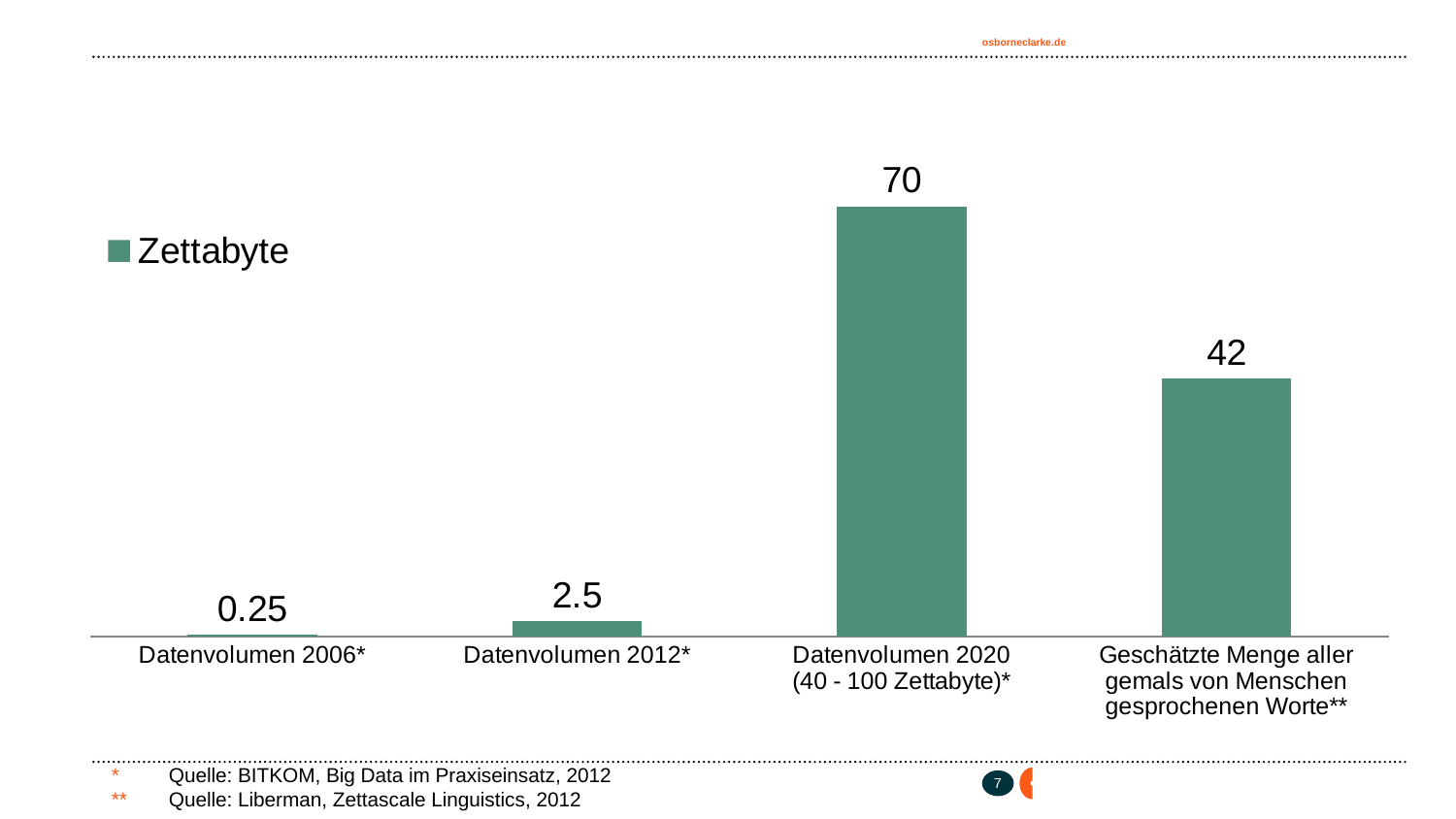
What kind of chart is shown on the slide? bar chart Which category has the lowest value? Datenvolumen 2006* Which category has the highest value? Datenvolumen 2020 (40 - 100 Zettabyte)* How many categories are shown on the x axis? 4 What is the value for Datenvolumen 2006*? 0.25 What is the value for Geschätzte Menge aller gemals von Menschen gesprochenen Worte**? 42 How many series does the legend list? 1 What is the value for Datenvolumen 2012*? 2.5 What is the difference between the values for Datenvolumen 2012* and Datenvolumen 2006*? 2.25 What is the value for Datenvolumen 2020 (40 - 100 Zettabyte)*? 70 Which is larger, the value for Datenvolumen 2020 (40 - 100 Zettabyte)* or the value for Geschätzte Menge aller gemals von Menschen gesprochenen Worte**? Datenvolumen 2020 (40 - 100 Zettabyte)* What is the difference between the values for Datenvolumen 2020 (40 - 100 Zettabyte)* and Geschätzte Menge aller gemals von Menschen gesprochenen Worte**? 28